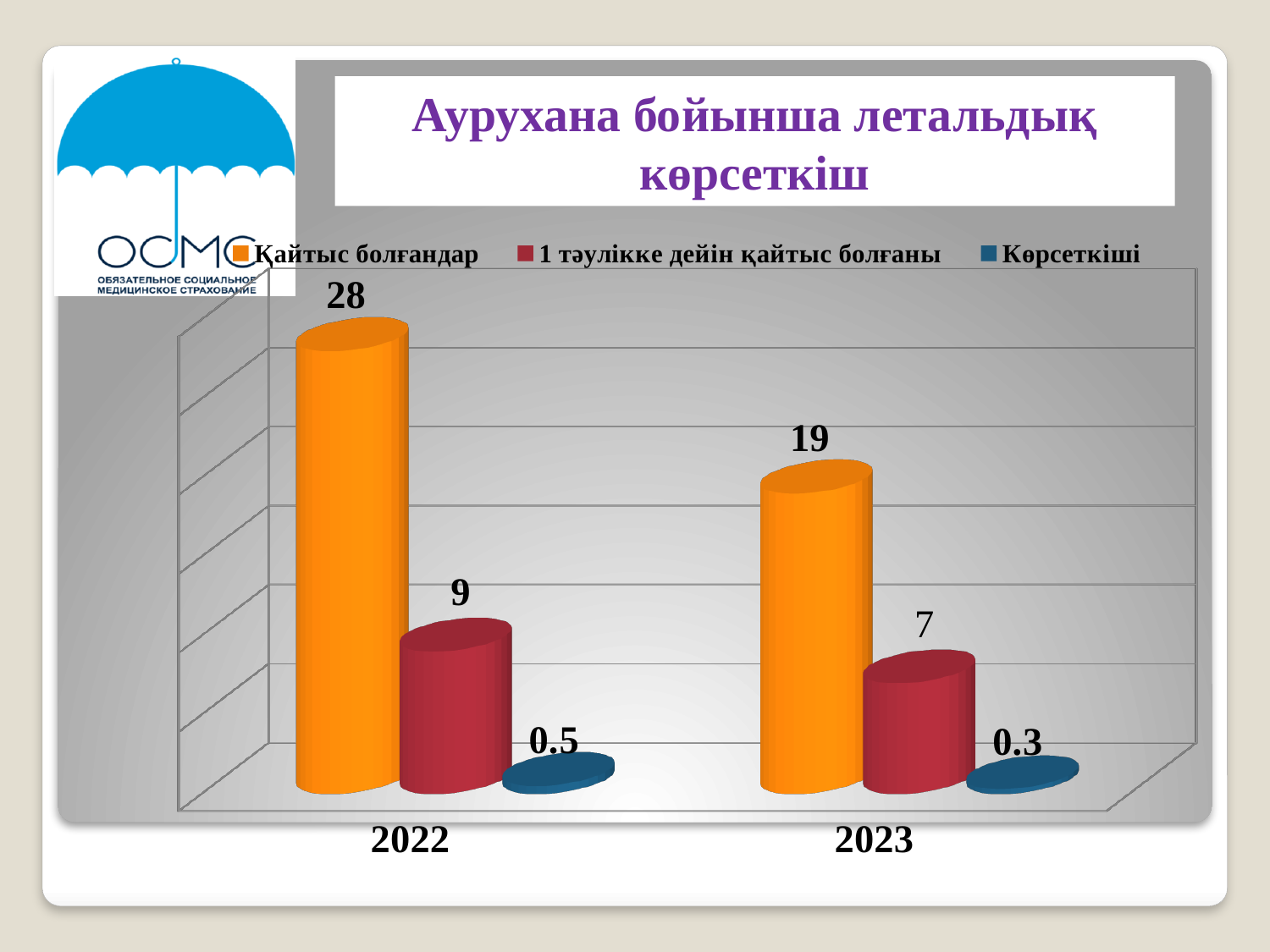
How many series does the legend list? 3 What is the value for Қайтыс болғандар in 2022? 28 What is the value for Көрсеткіші in 2022? 0.5 What is the value for 1 тәулікке дейін қайтыс болғаны in 2023? 7 What is the value for Көрсеткіші in 2023? 0.3 What kind of chart is shown on the slide? Bar chart Does the value for Қайтыс болғандар rise or fall from 2022 to 2023? Fall What is the difference between the Қайтыс болғандар values for 2022 and 2023? 9 Which year has the higher value for Қайтыс болғандар? 2022 What is the difference between the 1 тәулікке дейін қайтыс болғаны values for 2022 and 2023? 2 How many categories are shown on the x axis? 2 Which series has the lowest value in 2023? Көрсеткіші